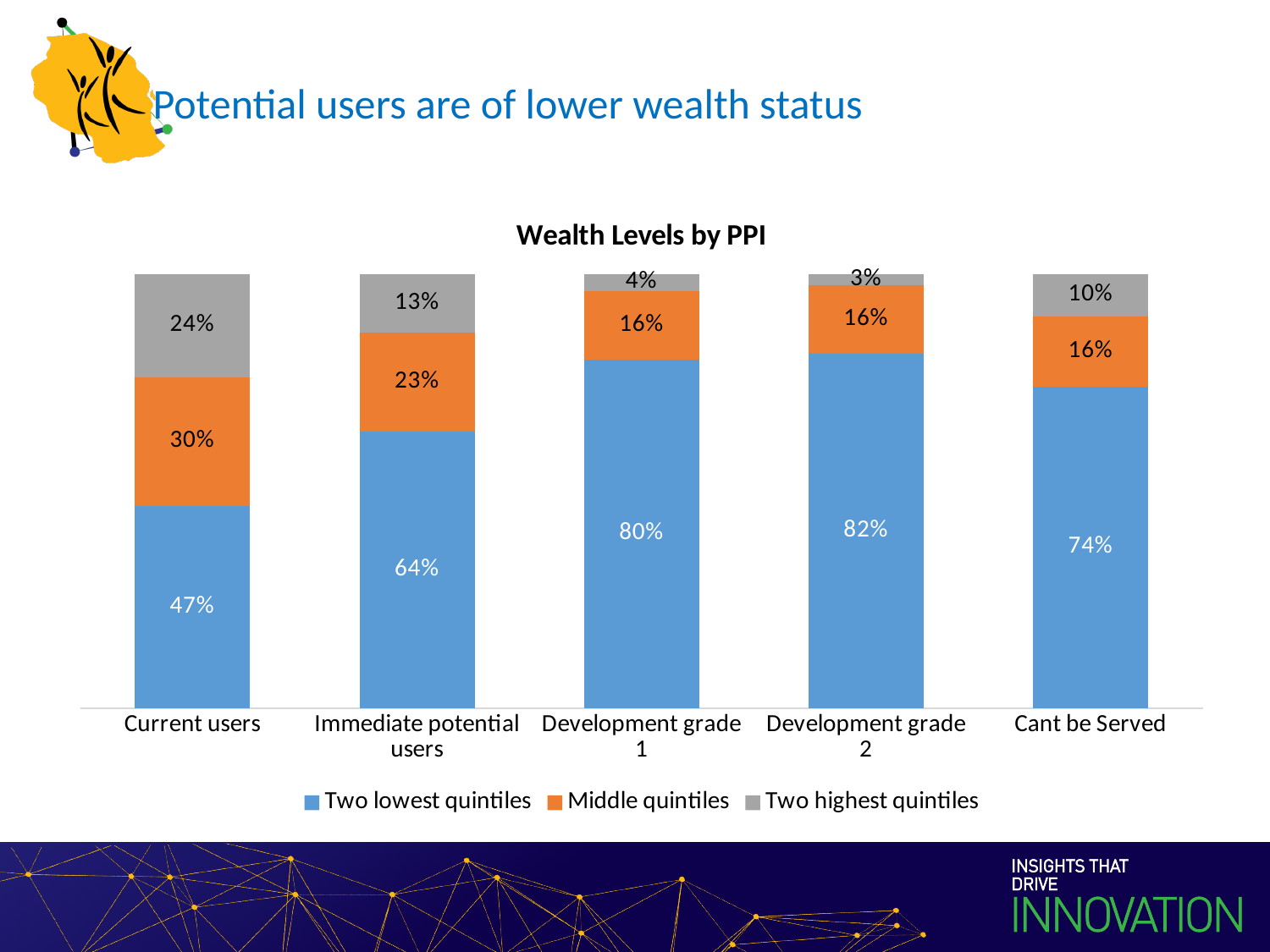
Which category has the highest value for Two lowest quintiles? Development grade 2 Which category has the lowest value for Two highest quintiles? Development grade 2 How many categories are shown on the x axis? 5 What is the value for Two highest quintiles for Cant be Served? 10% How many series does the legend list? 3 What is the title of the chart? Wealth Levels by PPI Which is larger: the Middle quintiles value for Current users or for Development grade 1? Current users What is the value for Two lowest quintiles for Current users? 47% What type of chart is shown on the slide? Stacked bar chart What is the difference between the Two lowest quintiles values for Development grade 1 and Current users? 33% What is the total of the stacked bar for Immediate potential users? 100% What is the value for Middle quintiles for Immediate potential users? 23%